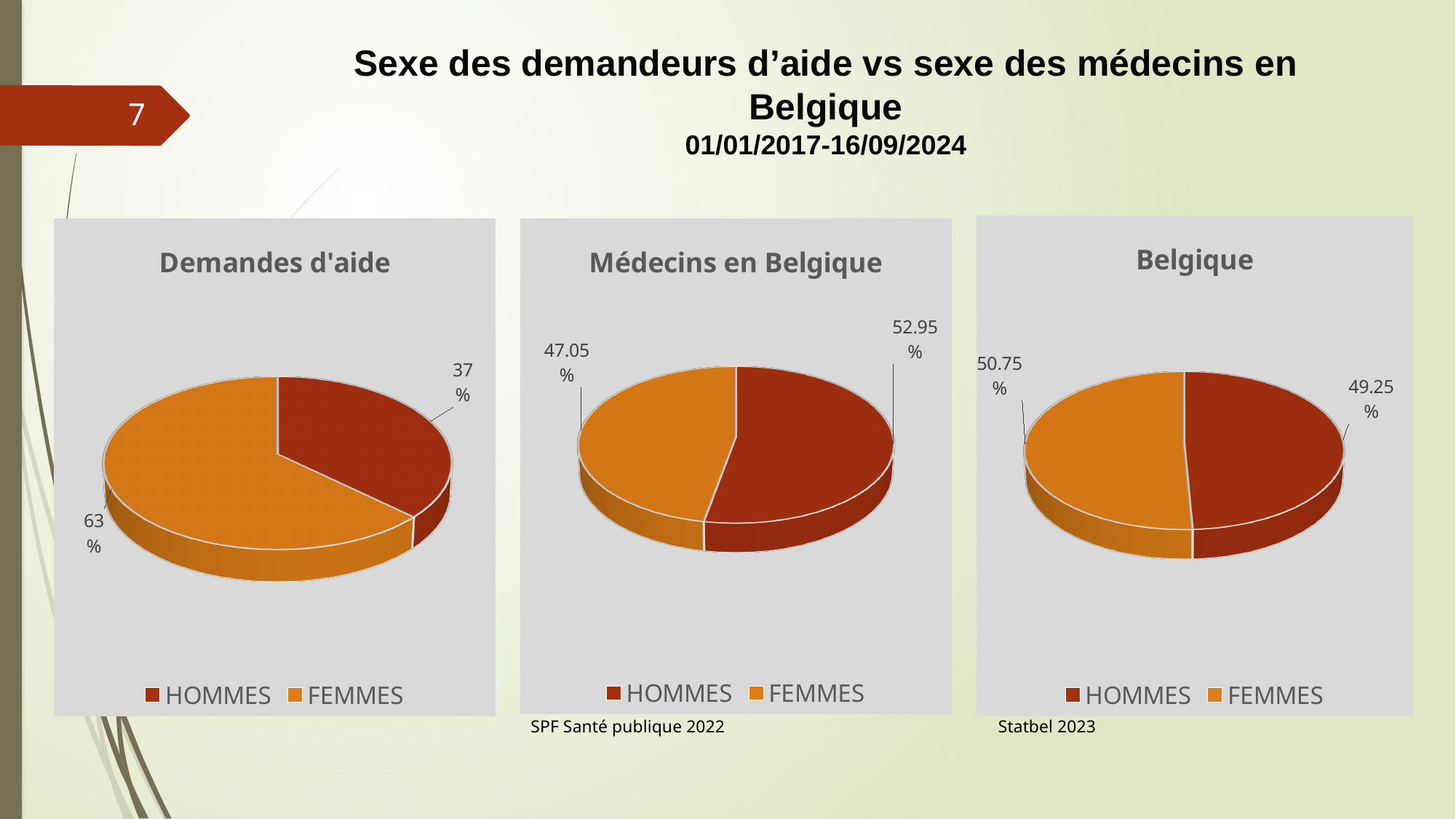
In the 'Médecins en Belgique' chart, what is the value for HOMMES? 52.95% In the 'Médecins en Belgique' chart, what is the value for FEMMES? 47.05% In the 'Belgique' chart, what is the value for FEMMES? 50.75% In the 'Médecins en Belgique' chart, what is the difference between the HOMMES and FEMMES values? 5.9% In the 'Demandes d'aide' chart, which category has the largest slice? FEMMES In the 'Demandes d'aide' chart, what share of the pie is HOMMES? 37% In the 'Médecins en Belgique' chart, which category has the smallest slice? FEMMES In the 'Demandes d'aide' chart, what is the difference between the FEMMES and HOMMES shares? 26% In the 'Demandes d'aide' chart, what share of the pie is FEMMES? 63% How many entries does the legend of the 'Demandes d'aide' chart list? 2 What kind of chart is the 'Belgique' chart? Pie chart In the 'Belgique' chart, what is the value for HOMMES? 49.25%